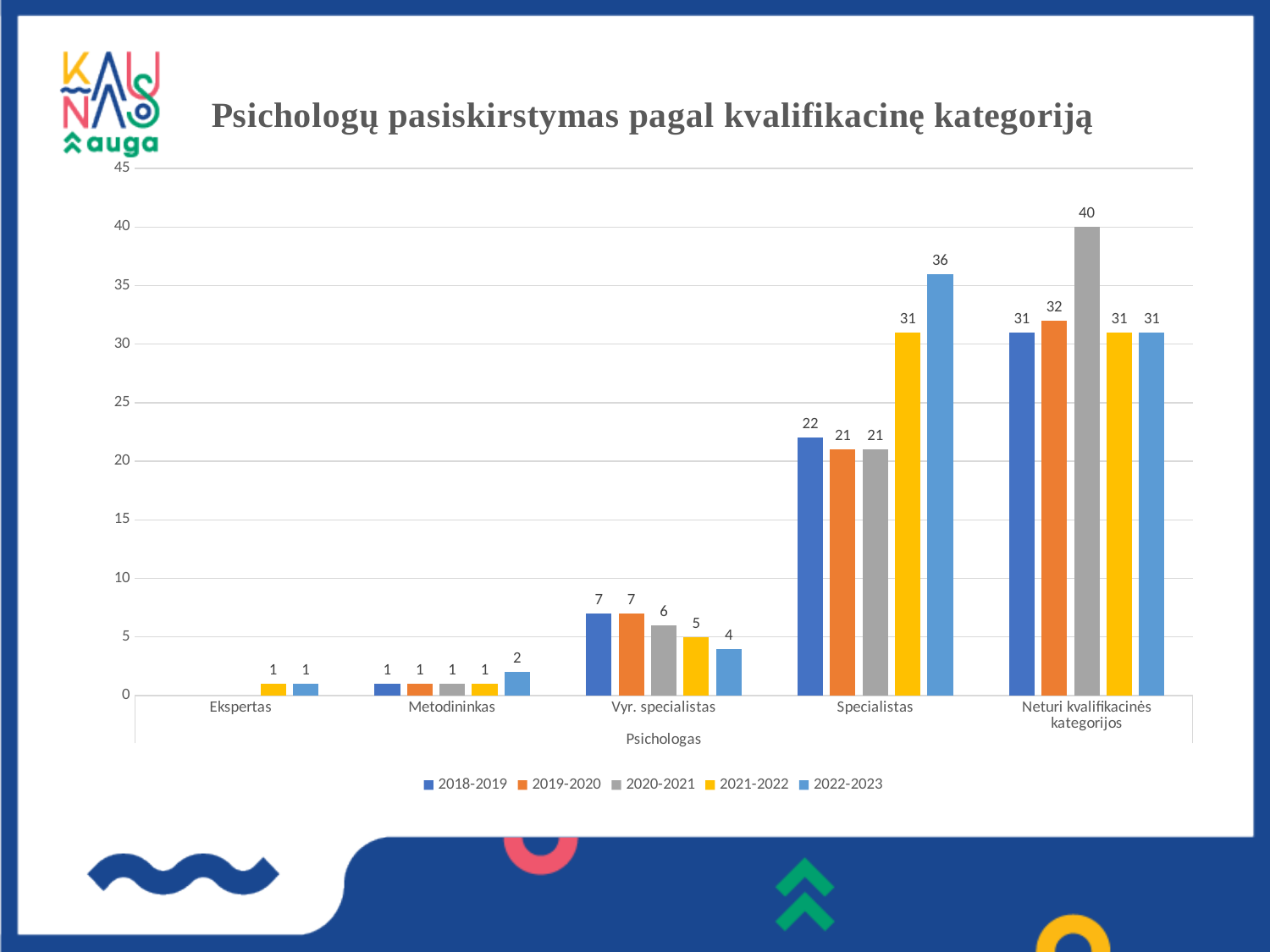
Which is larger for Vyr. specialistas: the 2018-2019 value or the 2022-2023 value? 2018-2019 Do the values for Vyr. specialistas rise or fall from the 2018-2019 series to the 2022-2023 series? Fall Which category has the lowest value in the 2022-2023 series? Ekspertas How many categories are shown on the x axis? 5 What is the value for Metodininkas in the 2022-2023 series? 2 What is the difference between the 2022-2023 and 2018-2019 values for Specialistas? 14 Which category has the highest value in the 2020-2021 series? Neturi kvalifikacinės kategorijos What is the value for Neturi kvalifikacinės kategorijos in the 2020-2021 series? 40 What is the value for Vyr. specialistas in the 2021-2022 series? 5 What is the value for Specialistas in the 2022-2023 series? 36 What kind of chart is shown on the slide? Bar chart How many series does the legend list? 5